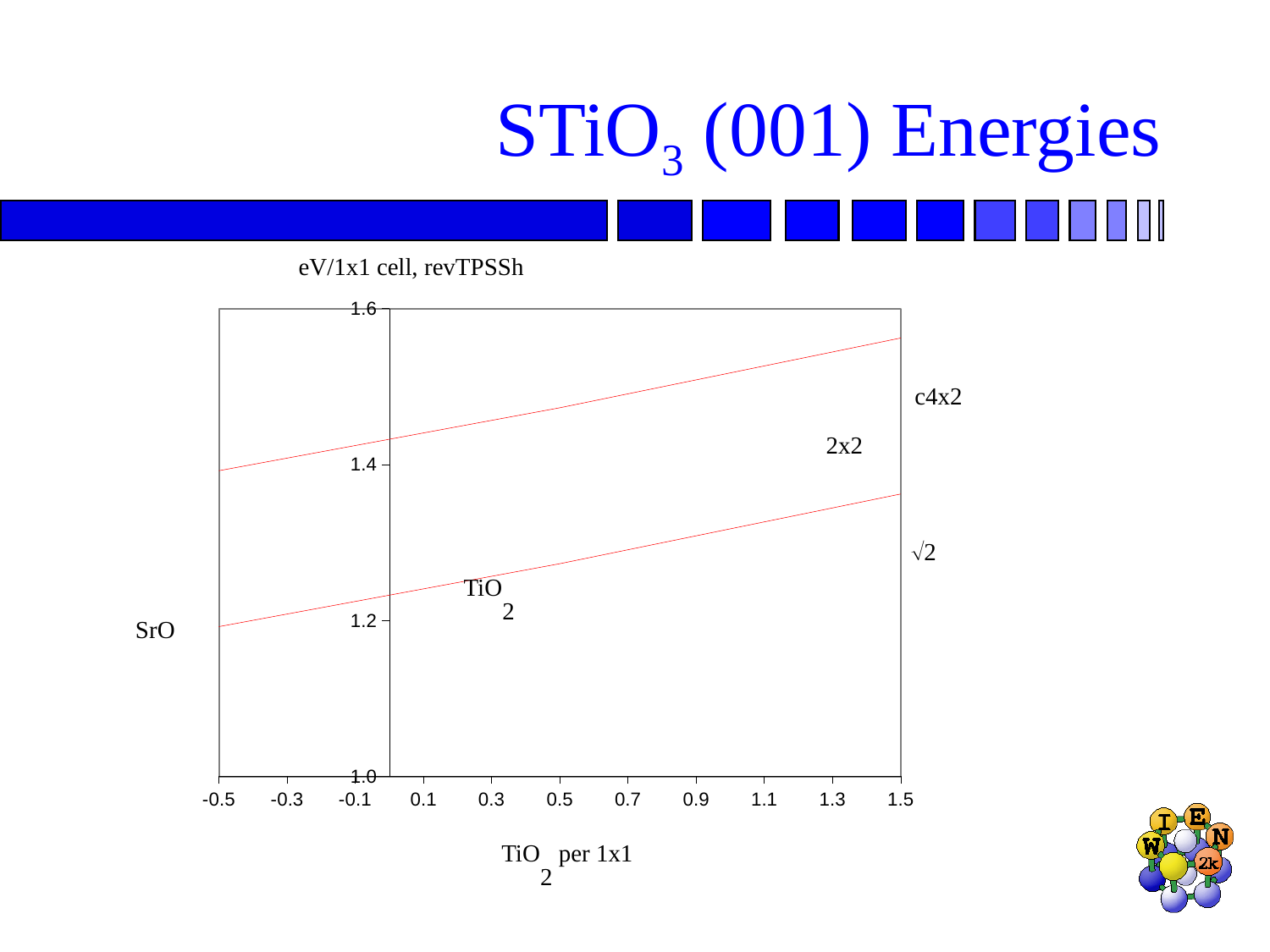
Is the value of the upper line at TiO2 per 1x1 = 1.5 greater or less than 1.6? less What kind of chart is shown on the slide? line chart What colour are the plotted lines? red Do the plotted lines rise or fall as TiO2 per 1x1 increases along the x axis? rise How many lines are plotted on the chart? 2 How many tick labels are shown on the x axis? 11 Is the value of the lower line at TiO2 per 1x1 = 1.5 greater or less than 1.2? greater Is the value of the lower line at TiO2 per 1x1 = 1.5 greater or less than 1.4? less What is the label on the y axis of the chart? eV/1x1 cell, revTPSSh At TiO2 per 1x1 = 0.5, which line has the larger value, the upper line or the lower line? the upper line